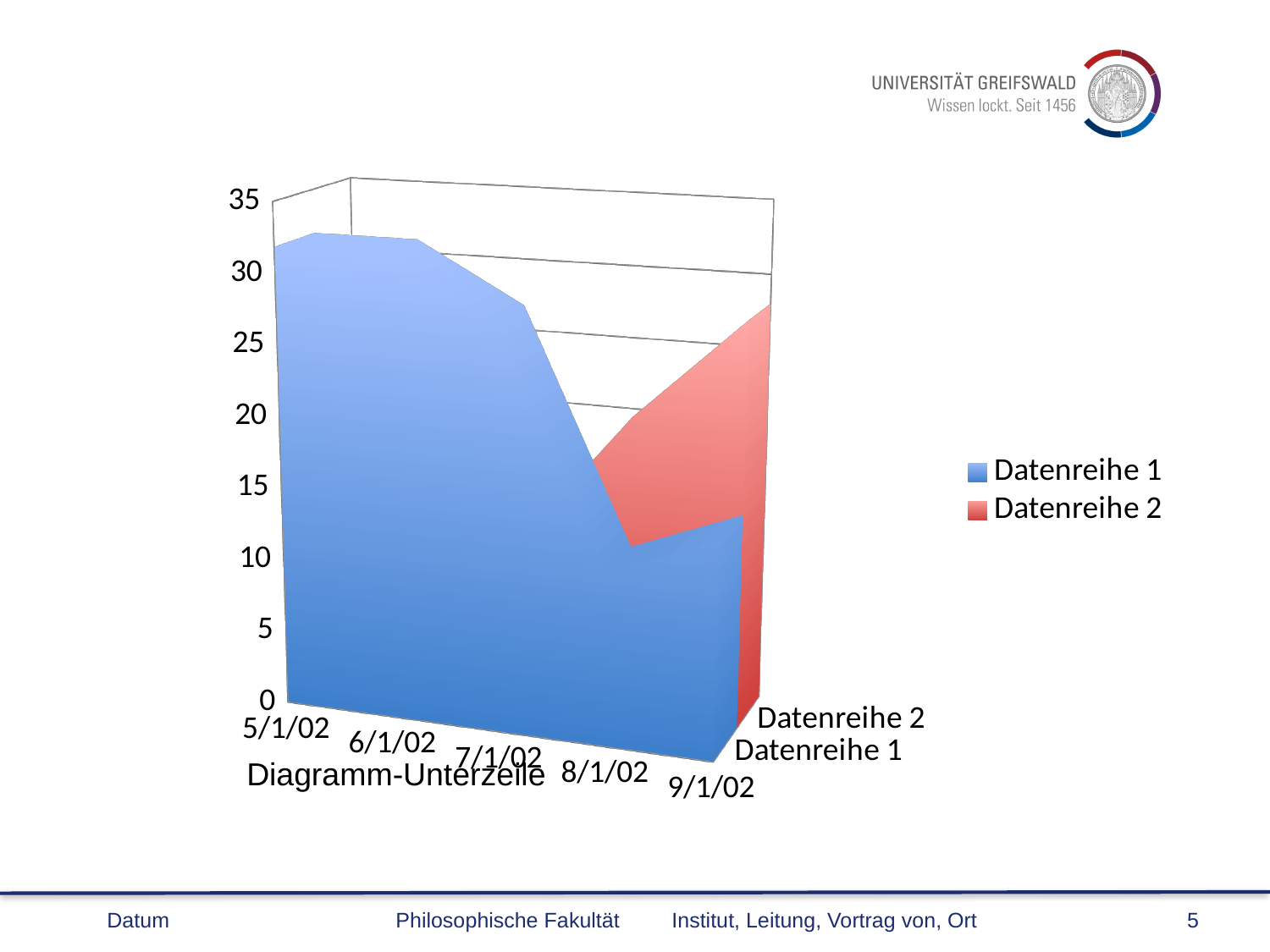
Is the value for Datenreihe 1 at 9/1/02 greater or less than 20? less Which series is shown in blue? Datenreihe 1 At which date is Datenreihe 1 lowest? 8/1/02 What text appears as the axis title below the x axis? Diagramm-Unterzeile Does Datenreihe 1 rise or fall overall from 5/1/02 to 9/1/02? fall Is the value for Datenreihe 2 at 9/1/02 greater or less than 20? greater At 9/1/02, which series has the larger value, Datenreihe 1 or Datenreihe 2? Datenreihe 2 How many series does the legend list? 2 Is the value for Datenreihe 1 at 8/1/02 greater or less than 15? less What kind of chart is shown on the slide? area chart How many dates are shown along the x axis? 5